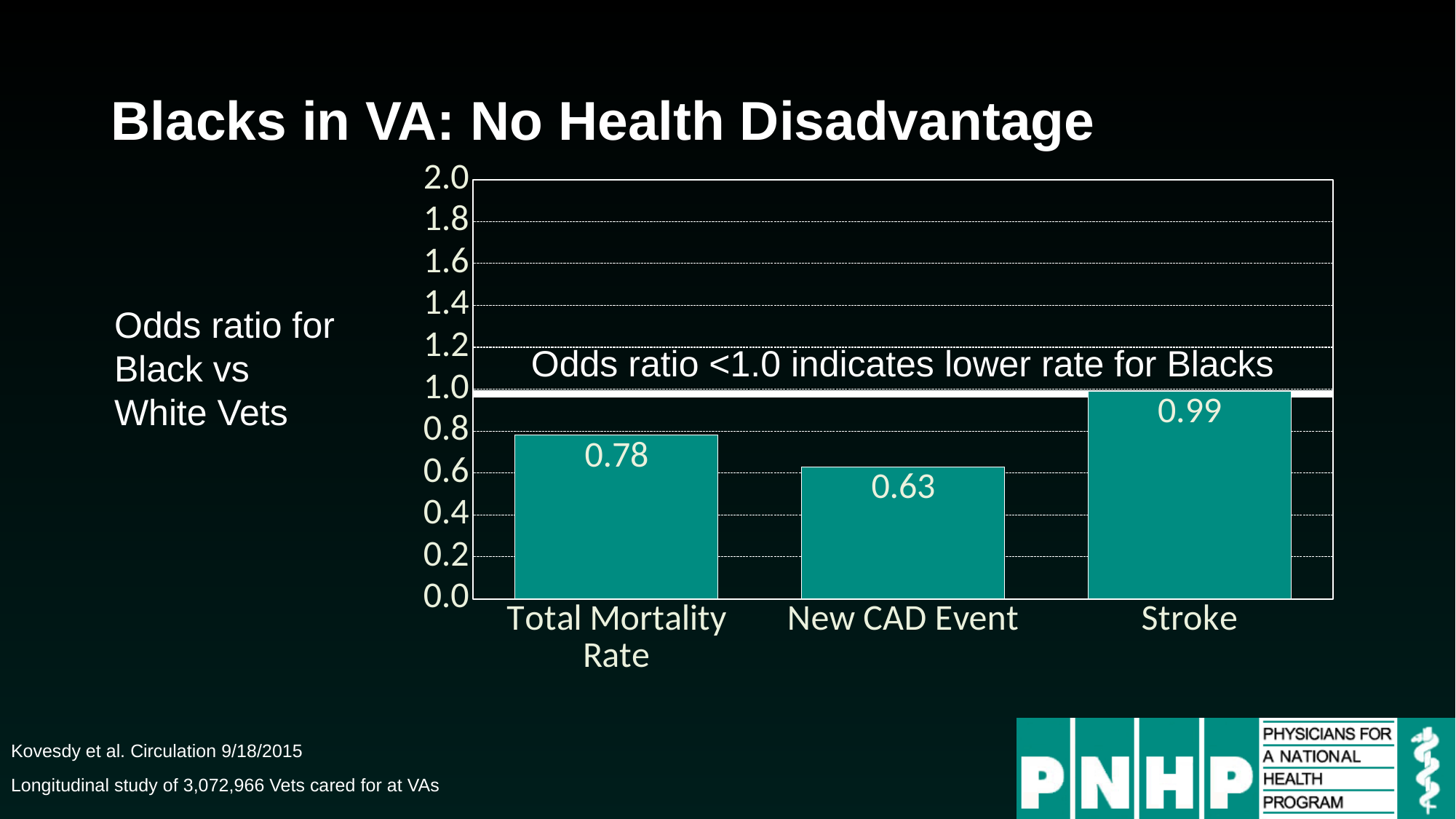
How many categories are shown on the x axis? 3 What is the odds ratio for New CAD Event? 0.63 Which category has the highest odds ratio? Stroke Is the odds ratio for Stroke greater or less than 1.0? less What is the maximum value shown on the y axis? 2.0 Which category has the lowest odds ratio? New CAD Event What kind of chart is shown on the slide? bar chart Which is larger, the odds ratio for Total Mortality Rate or for Stroke? Stroke What is the odds ratio for Stroke? 0.99 What is the difference between the odds ratios for Stroke and New CAD Event? 0.36 What is the difference between the odds ratios for Total Mortality Rate and New CAD Event? 0.15 What is the odds ratio for Total Mortality Rate? 0.78